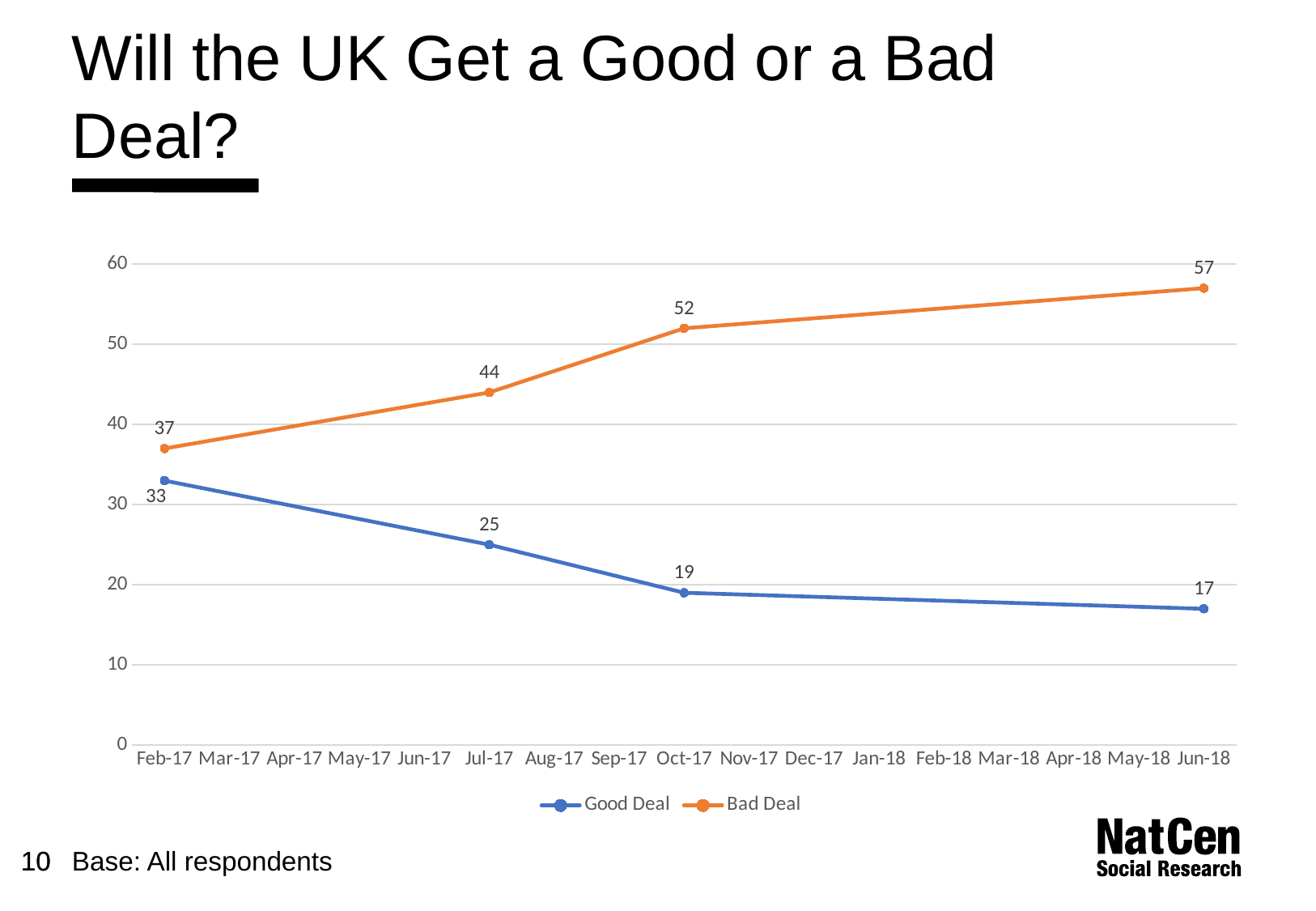
At which date is the Bad Deal series highest? Jun-18 Does the Good Deal series rise or fall from Feb-17 to Jun-18? Fall What is the difference between Bad Deal and Good Deal in Jun-18? 40 What kind of chart is shown on the slide? Line chart What is the value for Good Deal in Feb-17? 33 What is the value for Bad Deal in Jun-18? 57 What colour is the Bad Deal line? Orange What is the value for Good Deal in Oct-17? 19 At which date is the Good Deal series lowest? Jun-18 How many series does the legend list? 2 Which series has the larger value in Feb-17, Good Deal or Bad Deal? Bad Deal What is the value for Bad Deal in Jul-17? 44